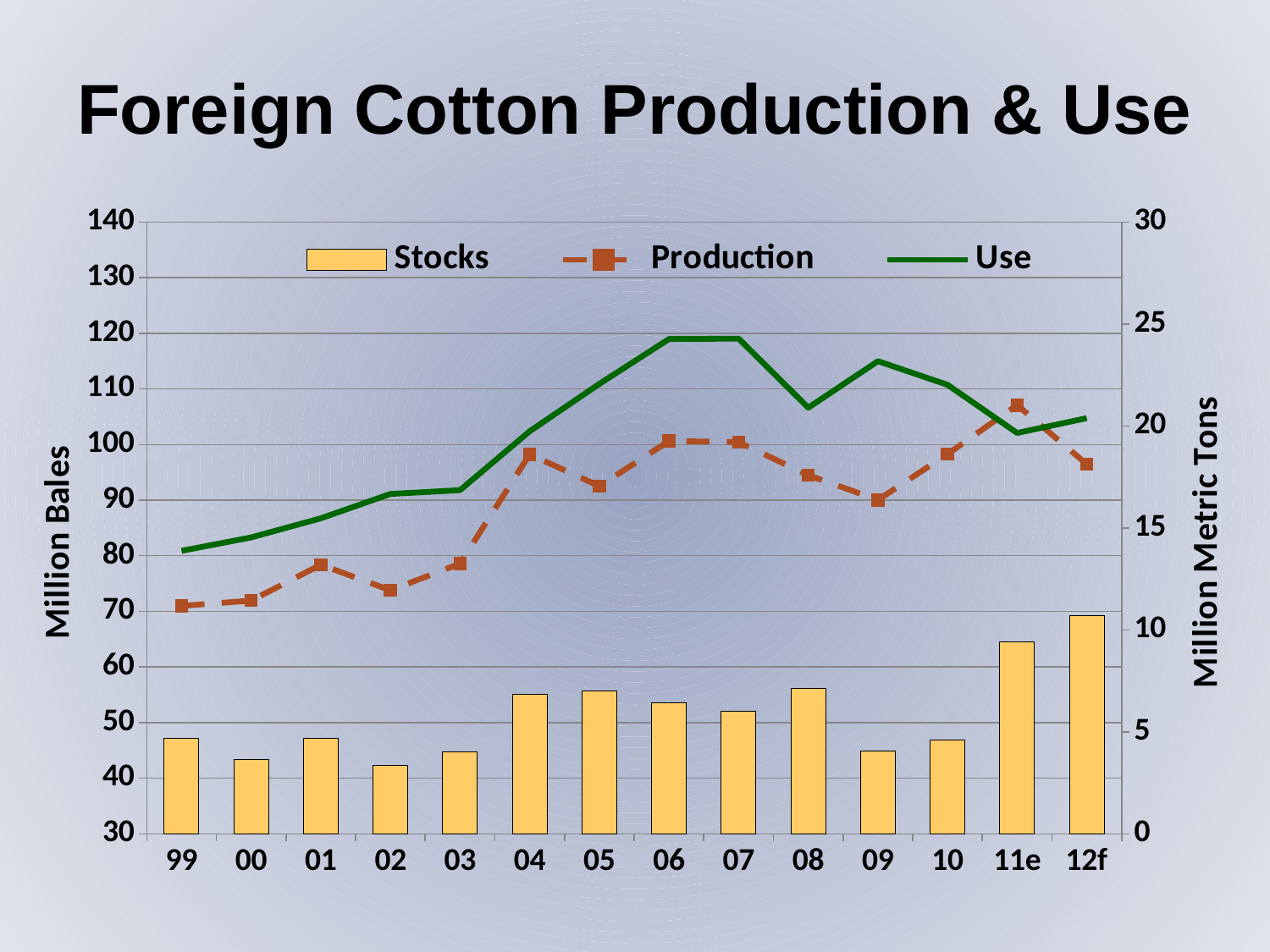
Is the Stocks value for 12f greater or less than 60? greater What is the title of the chart? Foreign Cotton Production & Use In which year are Stocks highest? 12f Is the Use value for 06 greater or less than 20 on the right axis? greater How many years are shown along the x axis? 14 In which year is Production highest? 11e Do Stocks rise or fall from 10 to 12f? rise How many series does the legend list? 3 What kind of chart is this? Combined bar and line chart In which year is Use lowest? 99 Is the Stocks value for 02 greater or less than 50? less What is the label of the left vertical axis? Million Bales